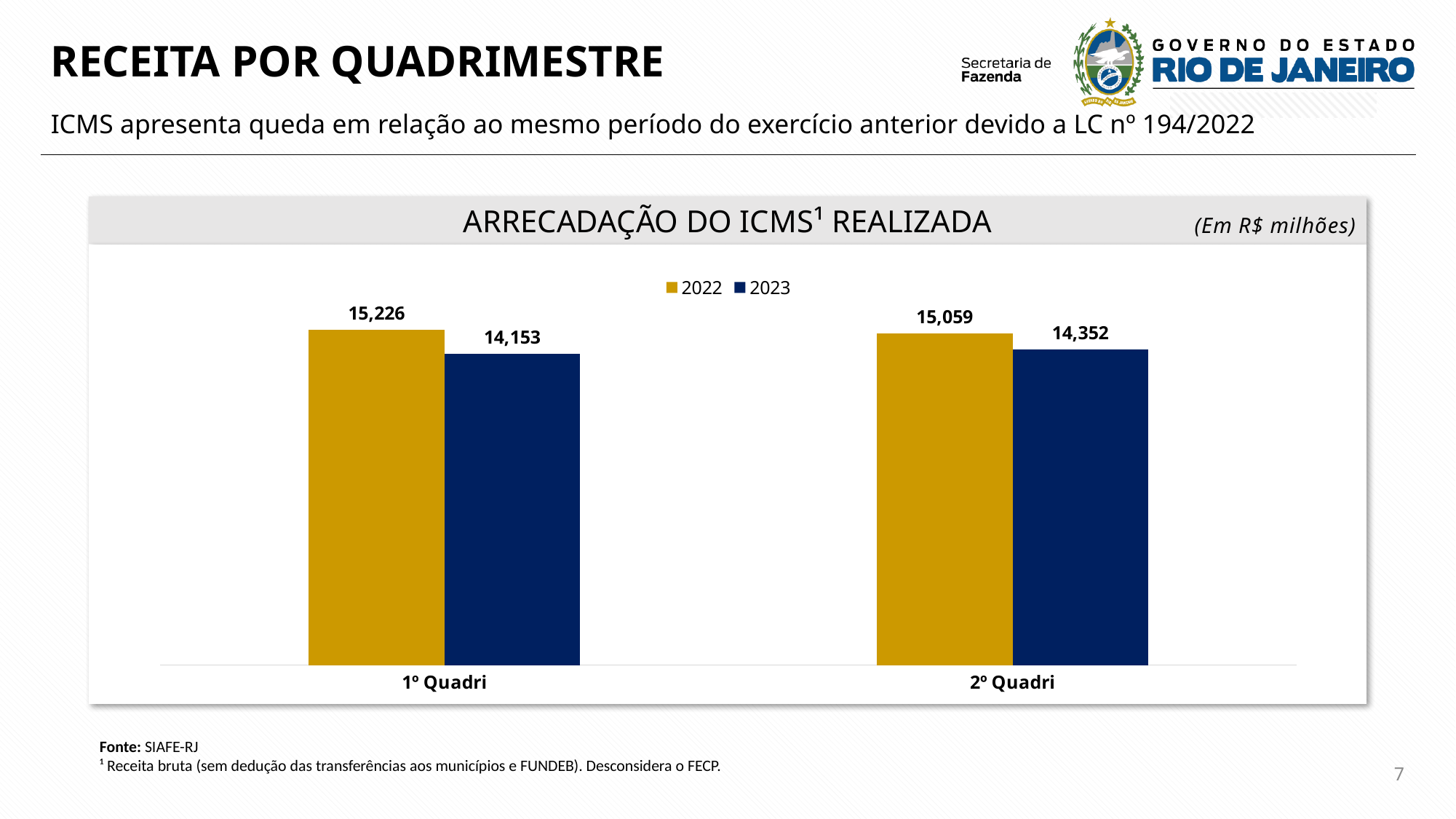
How many categories are shown on the x axis? 2 What kind of chart is shown on the slide? Bar chart What is the difference between the 2022 and 2023 values for 2º Quadri? 707 Which category has the highest 2022 value? 1º Quadri What is the 2023 value for 1º Quadri? 14,153 Which category has the lowest 2023 value? 1º Quadri What is the 2022 value for 1º Quadri? 15,226 Which is larger for 2º Quadri, the 2022 value or the 2023 value? 2022 What is the 2022 value for 2º Quadri? 15,059 What is the difference between the 2022 and 2023 values for 1º Quadri? 1,073 How many series does the legend list? 2 What is the 2023 value for 2º Quadri? 14,352